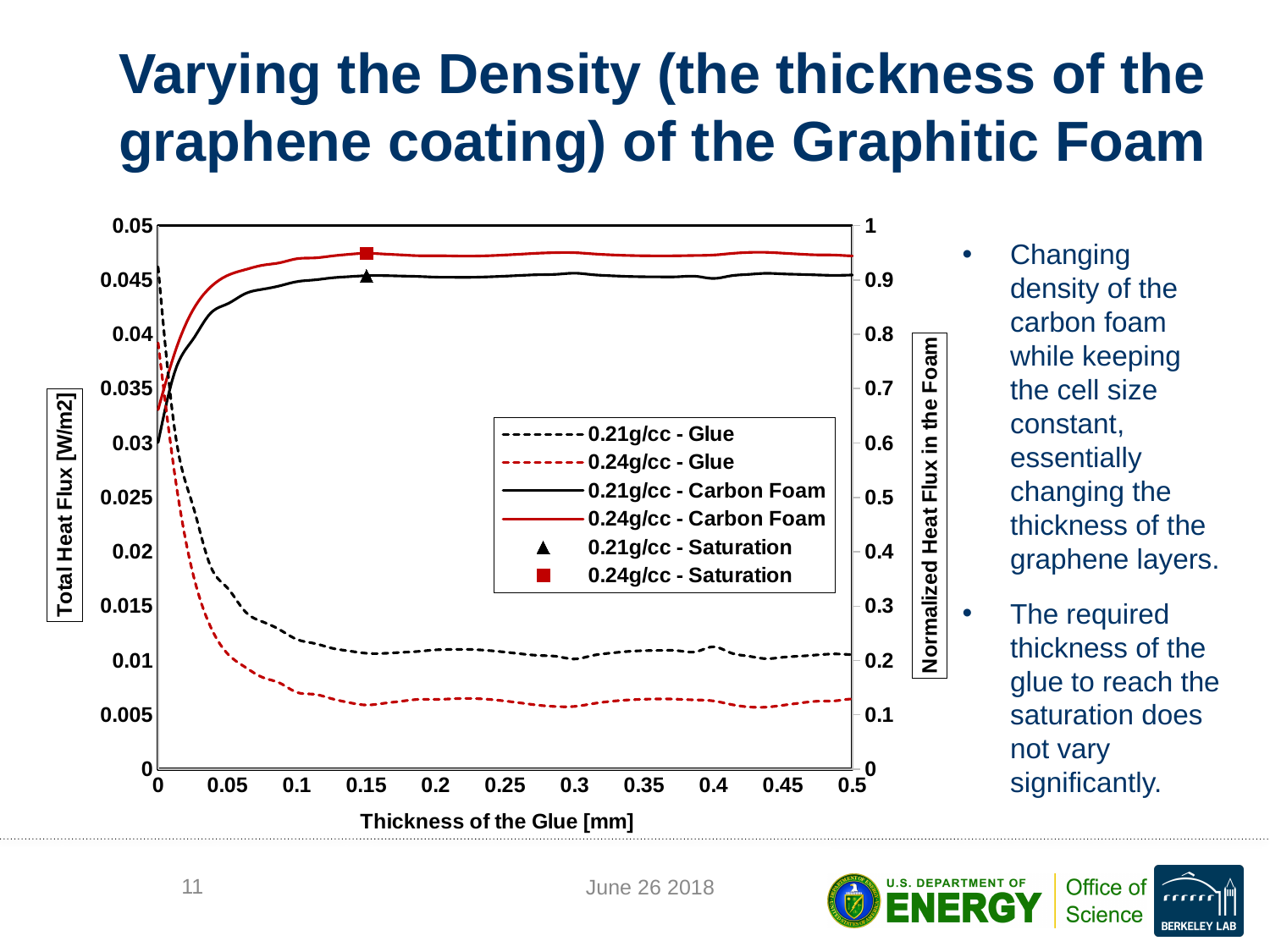
Does the 0.24g/cc - Carbon Foam series rise or fall as the thickness of the glue increases? rise What is the label of the x axis? Thickness of the Glue [mm] How many series does the legend list? 6 At a glue thickness of 0.5 mm, which is larger: 0.21g/cc - Glue or 0.24g/cc - Glue? 0.21g/cc - Glue Is the value for 0.24g/cc - Carbon Foam at a glue thickness of 0.5 mm greater or less than 0.045 on the left axis? greater What kind of chart is shown on the slide? line chart Does the 0.21g/cc - Glue series rise or fall as the thickness of the glue increases? fall Is the value for 0.21g/cc - Glue at a glue thickness of 0.5 mm greater or less than 0.015 on the left axis? less What is the maximum value shown on the right y axis (Normalized Heat Flux in the Foam)? 1 At what glue thickness on the x axis are the 0.21g/cc - Saturation and 0.24g/cc - Saturation markers plotted? 0.15 At a glue thickness of 0.5 mm, which is larger: 0.21g/cc - Carbon Foam or 0.24g/cc - Carbon Foam? 0.24g/cc - Carbon Foam What is the label of the left y axis? Total Heat Flux [W/m2]